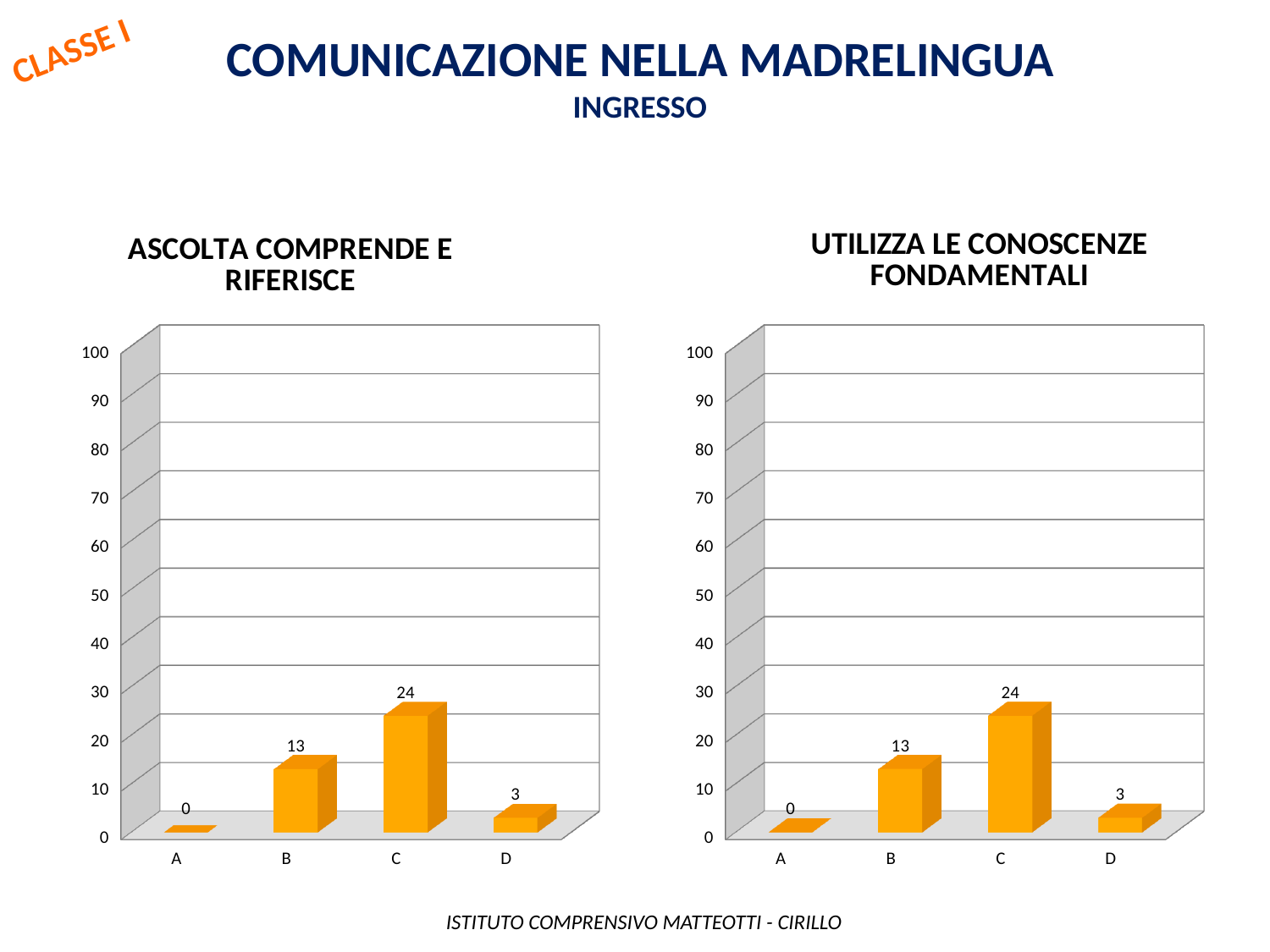
In the 'UTILIZZA LE CONOSCENZE FONDAMENTALI' chart, which category has the lowest value? A In the 'UTILIZZA LE CONOSCENZE FONDAMENTALI' chart, what is the value for category A? 0 In the 'UTILIZZA LE CONOSCENZE FONDAMENTALI' chart, is the value for C greater or less than 20? greater In the 'UTILIZZA LE CONOSCENZE FONDAMENTALI' chart, what is the difference between the values for B and D? 10 In the 'ASCOLTA COMPRENDE E RIFERISCE' chart, what is the value for category C? 24 In the 'ASCOLTA COMPRENDE E RIFERISCE' chart, what is the value for category B? 13 In the 'ASCOLTA COMPRENDE E RIFERISCE' chart, which is larger, the value for B or the value for D? B In the 'UTILIZZA LE CONOSCENZE FONDAMENTALI' chart, what is the value for category D? 3 In the 'ASCOLTA COMPRENDE E RIFERISCE' chart, what is the difference between the values for C and B? 11 In the 'ASCOLTA COMPRENDE E RIFERISCE' chart, which category has the highest value? C How many categories are shown on the x axis of the 'ASCOLTA COMPRENDE E RIFERISCE' chart? 4 What kind of chart is the 'UTILIZZA LE CONOSCENZE FONDAMENTALI' chart? Bar chart